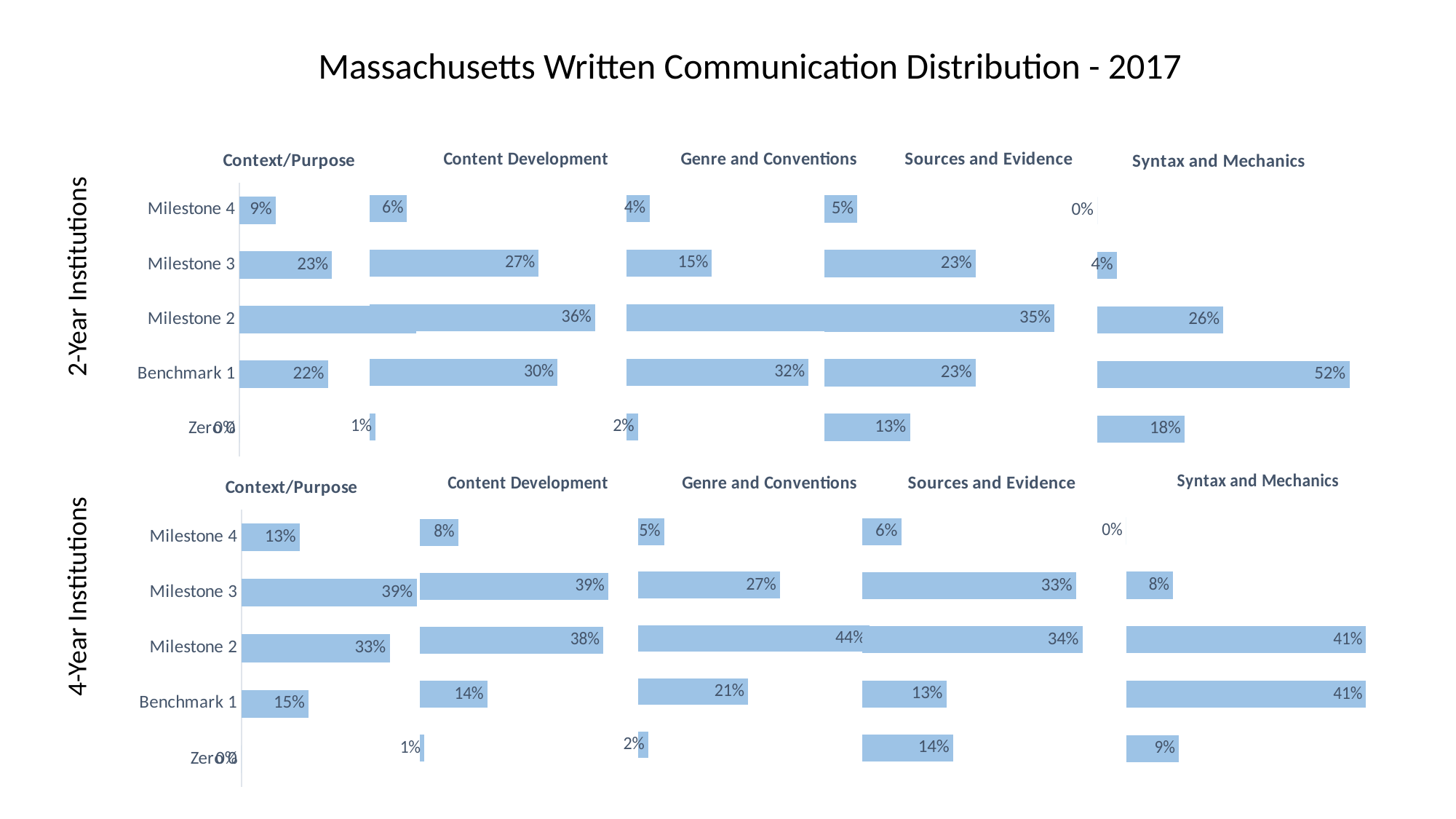
In the 4-Year Institutions Content Development chart, what is the difference between Milestone 3 and Benchmark 1? 25% In the 4-Year Institutions Context/Purpose chart, which category has the lowest value? Zero In the 2-Year Institutions Syntax and Mechanics chart, what is the value for Benchmark 1? 52% In the 2-Year Institutions Content Development chart, what is the value for Milestone 3? 27% In the 4-Year Institutions Genre and Conventions chart, what is the value for Milestone 2? 44% How many categories are shown on the vertical axis of the 4-Year Institutions Context/Purpose chart? 5 In the 4-Year Institutions Syntax and Mechanics chart, which is larger: Milestone 3 or Zero? Zero In the 4-Year Institutions Sources and Evidence chart, what is the value for Zero? 14% What type of chart is used for the 2-Year Institutions Content Development data? Bar chart In the 2-Year Institutions Genre and Conventions chart, which is larger: Benchmark 1 or Milestone 3? Benchmark 1 In the 2-Year Institutions Sources and Evidence chart, what is the difference between Milestone 3 and Zero? 10% In the 2-Year Institutions Syntax and Mechanics chart, which category has the highest value? Benchmark 1